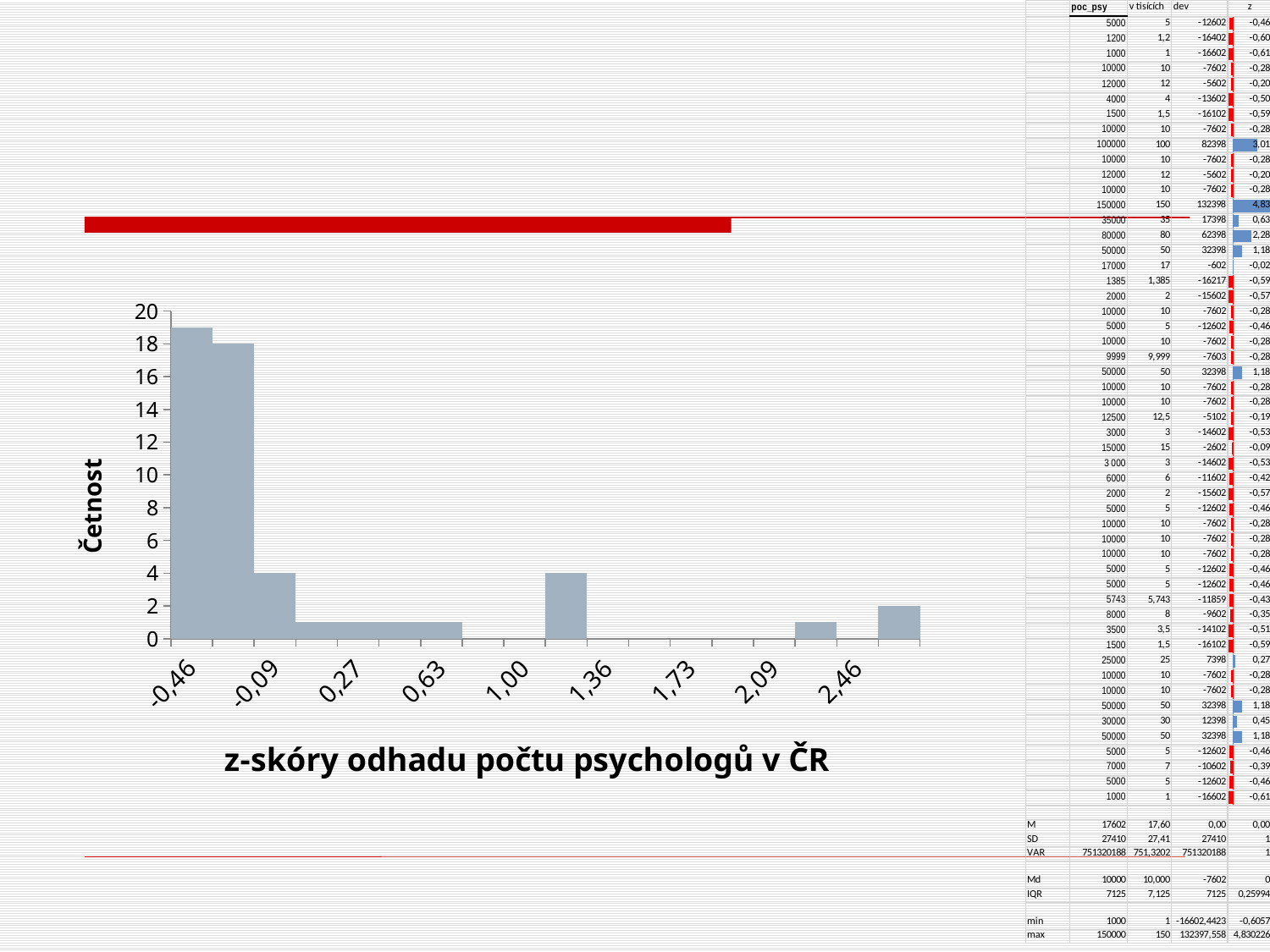
Is the frequency of the bar at z-score 2,09 greater or less than 2? less What kind of chart is shown on the slide? bar chart Is the frequency of the leftmost bar (at -0,46) greater or less than 18? greater Do the frequencies generally rise or fall as the z-score increases along the x axis? fall Which bar is taller: the leftmost bar at -0,46 or the bar at 1,36? the leftmost bar at -0,46 What is the title of the x axis of the chart? z-skóry odhadu počtu psychologů v ČR How many labels are shown on the x axis of the chart? 9 What is the highest value shown on the y axis of the chart? 20 What is the title of the y axis of the chart? Četnost